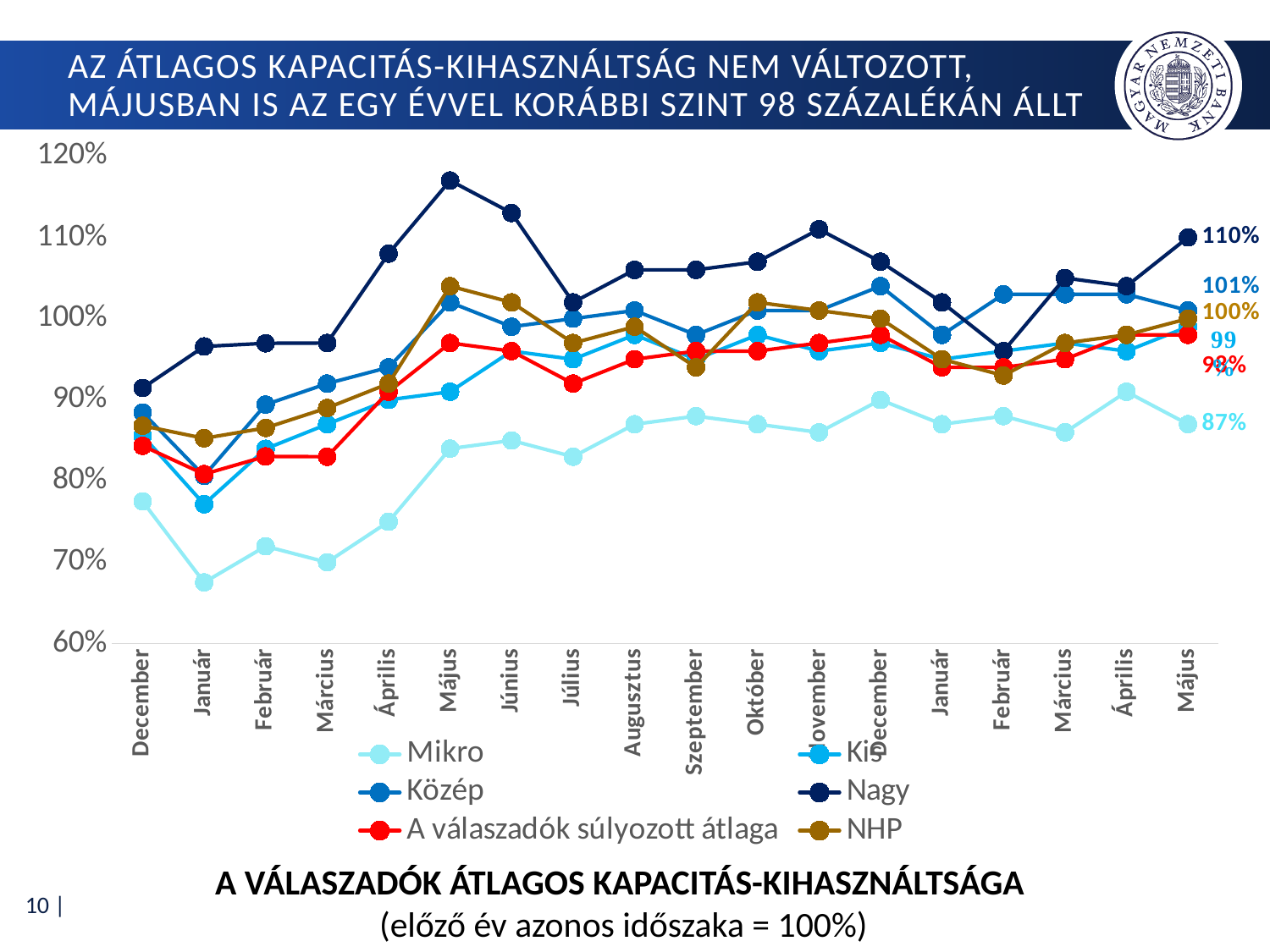
How many series does the legend list? 6 Which series has the lowest value at the final Május (rightmost point)? Mikro What is the value of the NHP series at the final Május (rightmost point)? 100% Which series has the highest value at the final Május (rightmost point)? Nagy Is the value of the Mikro series at the first Január less or greater than 70%? less How many months are shown along the x axis? 18 What kind of chart is shown on the slide? line chart What is the value of the Mikro series at the final Május (rightmost point)? 87% What is the value of the Nagy series at the final Május (rightmost point)? 110% What is the value of the Közép series at the final Május (rightmost point)? 101% What is the difference between the Nagy and Mikro values at the final Május (rightmost point)? 23 percentage points Is the value of the Nagy series at the first Május greater or less than 110%? greater